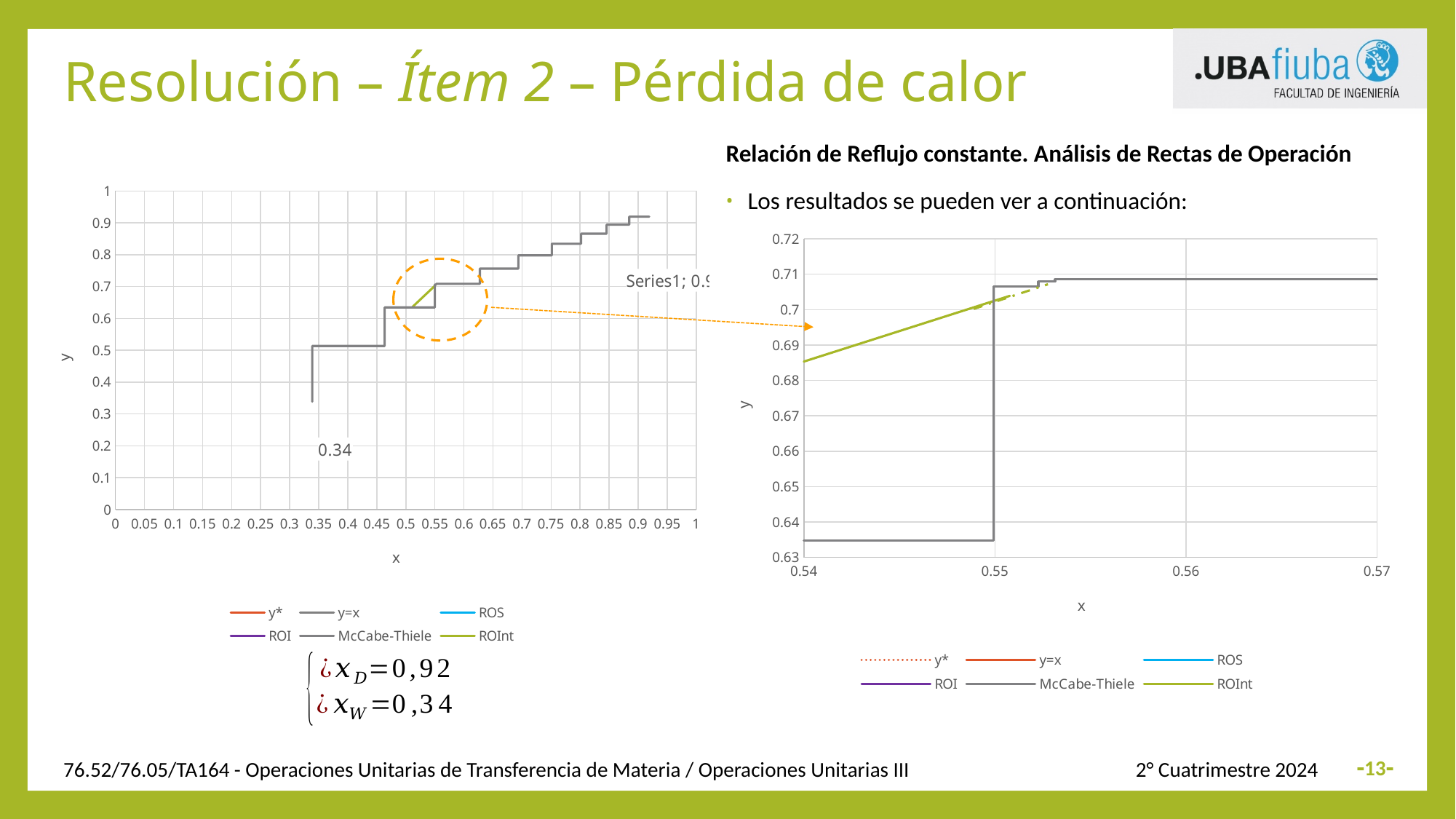
On the left chart, is the McCabe-Thiele value at x = 0.8 greater or less than 0.8? greater How many series does the legend of the right (zoomed) chart list? 6 On the left chart, what value is printed as a data label near the bottom of the staircase at x = 0.34? 0.34 How many series does the legend of the left chart list? 6 On the right (zoomed) chart, does the ROInt line rise or fall as x increases from 0.54 to 0.55? rise On the right (zoomed) chart, is the McCabe-Thiele value at x = 0.56 greater or less than 0.7? greater On the left chart, is the McCabe-Thiele value at x = 0.5 greater or less than 0.6? greater What is the label of the x axis on the right (zoomed) chart? x On the left chart, do the McCabe-Thiele staircase values rise or fall as x increases? rise What kind of chart is the left chart on the slide? line chart In the legend of the left chart, which series is drawn in green? ROInt